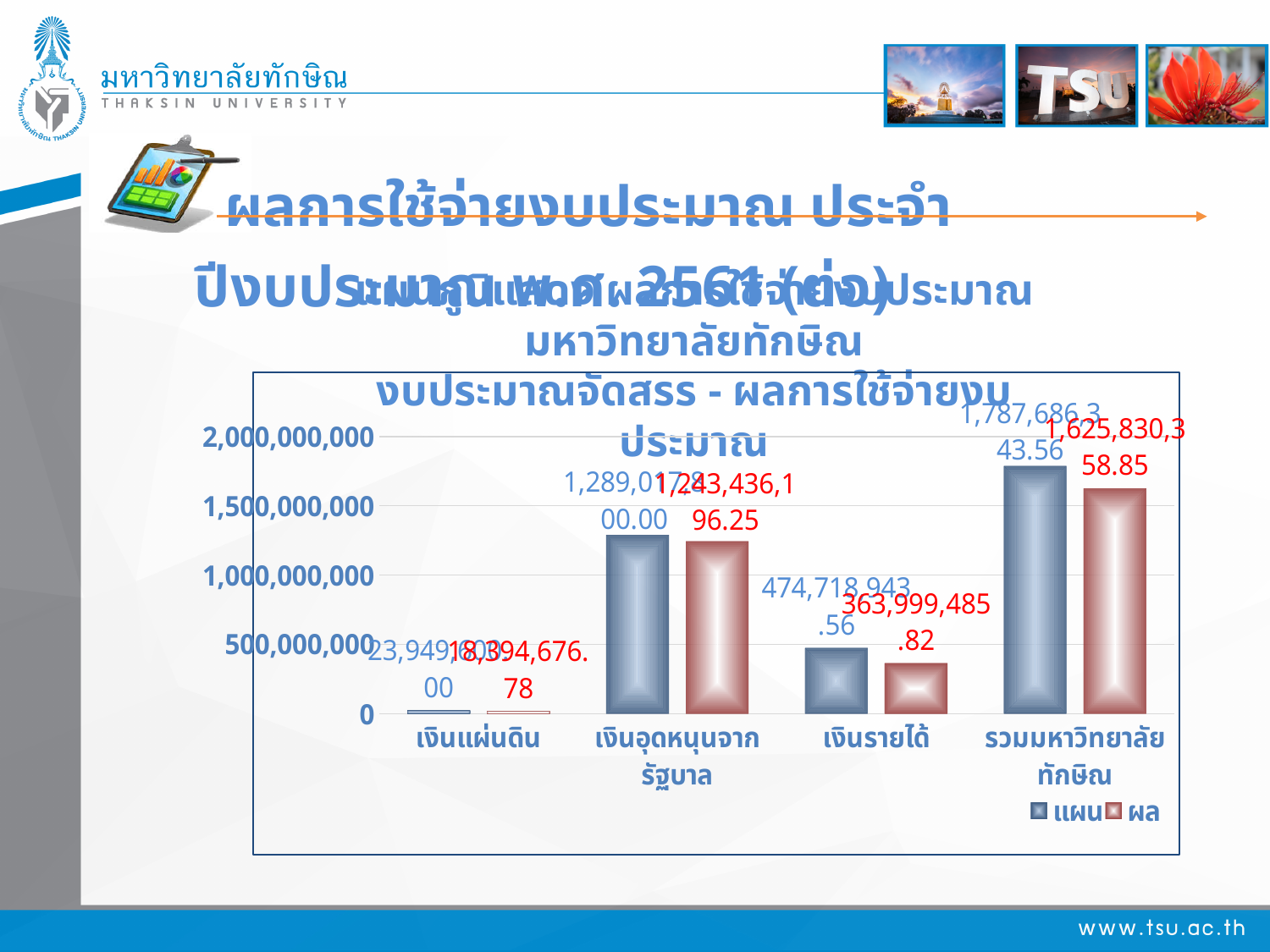
For เงินรายได้, which is larger, แผน or ผล? แผน What kind of chart is shown on the slide? bar chart Which category has the lowest ผล value? เงินแผ่นดิน What is the แผน value for เงินรายได้? 474,718,943.56 How many series does the chart legend list? 2 Is the ผล value for เงินอุดหนุนจากรัฐบาล greater or less than 1,000,000,000? greater How many categories are shown on the x axis of the chart? 4 What is the difference between the แผน and ผล values for เงินรายได้? 110,719,457.74 Which category has the highest แผน value? รวมมหาวิทยาลัยทักษิณ What is the ผล value for เงินรายได้? 363,999,485.82 What are the two series named in the legend? แผน and ผล Is the แผน value for รวมมหาวิทยาลัยทักษิณ greater or less than 1,500,000,000? greater